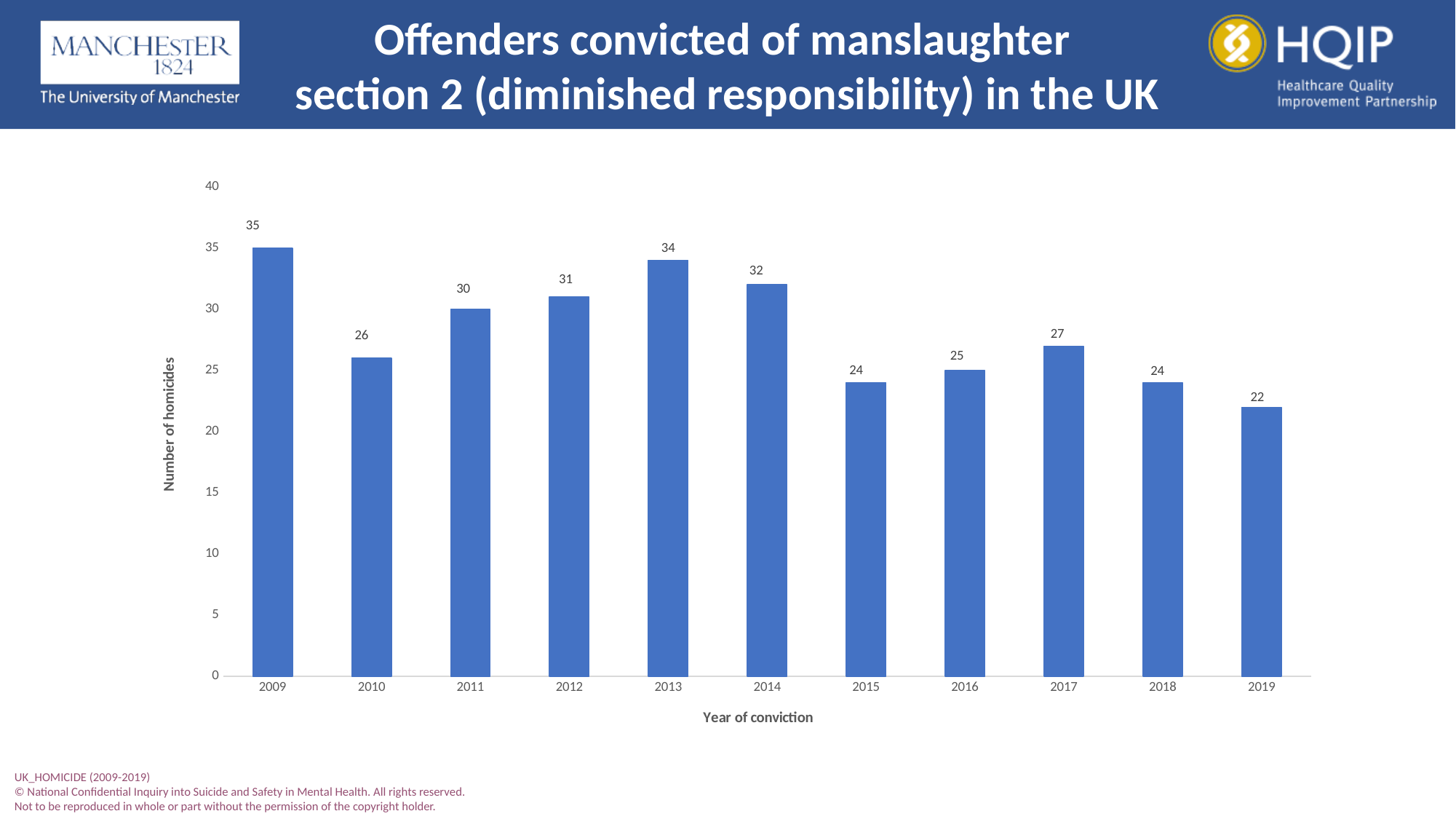
What is the label of the y axis? Number of homicides Which year has a larger number of homicides, 2012 or 2017? 2012 Is the value for 2016 greater or less than 30? less How many years are shown on the x axis? 11 What kind of chart is shown on the slide? bar chart What is the number of homicides for 2013? 34 What is the number of homicides for 2019? 22 Which year has the lowest number of homicides? 2019 What is the difference between the number of homicides in 2009 and 2019? 13 Which year has the highest number of homicides? 2009 What is the number of homicides for 2010? 26 What is the difference between the number of homicides in 2014 and 2015? 8